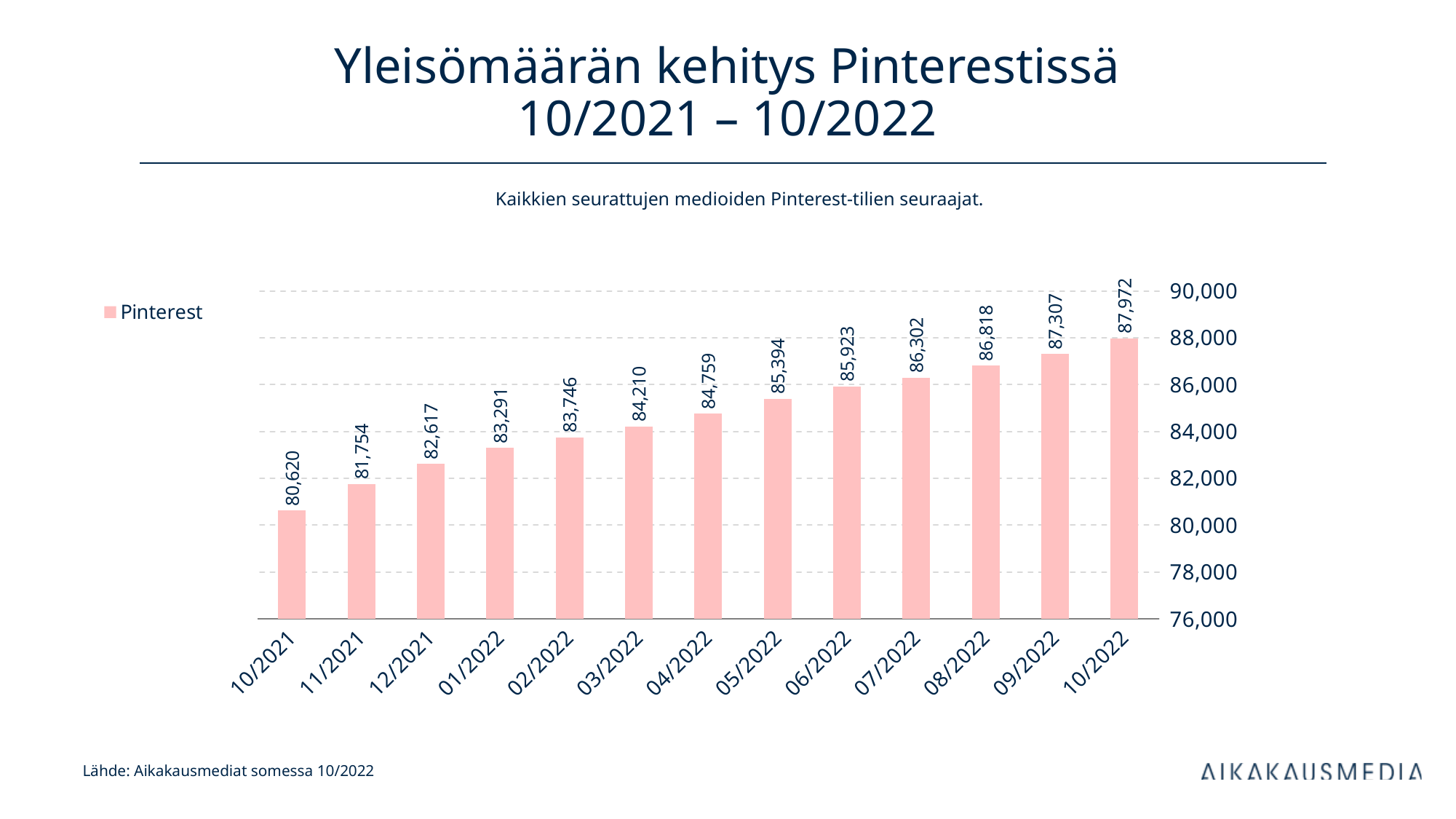
What is the Pinterest follower value for 10/2021? 80,620 What is the Pinterest follower value for 10/2022? 87,972 What is the difference between the values for 10/2022 and 10/2021? 7,352 Is the value for 06/2022 greater or less than 84,000? greater How many months are shown on the x axis? 13 What is the Pinterest follower value for 05/2022? 85,394 Do the values rise or fall from 10/2021 to 10/2022? rise What kind of chart is shown on the slide? bar chart What is the difference between the values for 03/2022 and 02/2022? 464 Which is larger, the value for 01/2022 or the value for 04/2022? 04/2022 Which month has the highest Pinterest follower value? 10/2022 Which month has the lowest Pinterest follower value? 10/2021